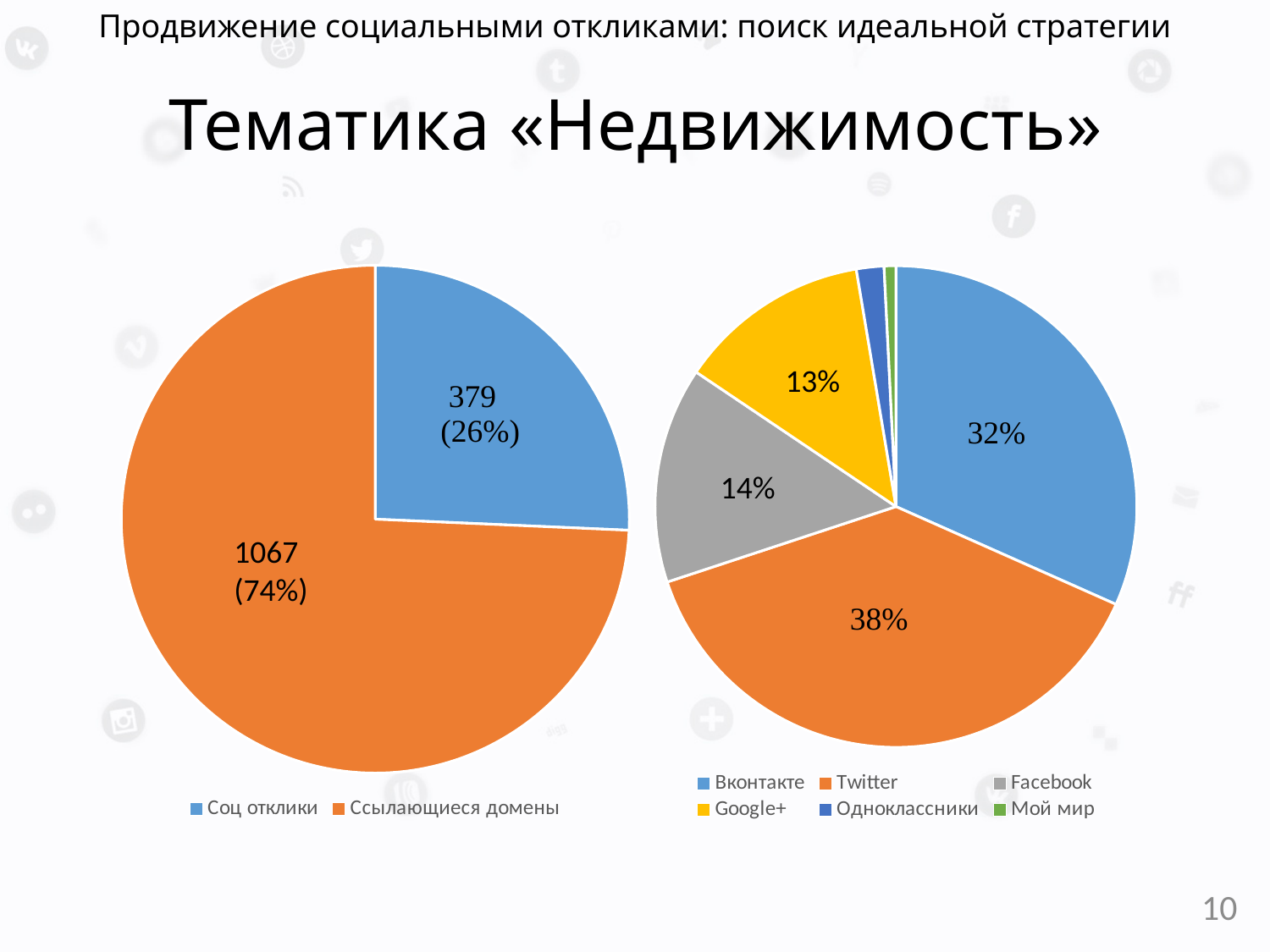
How many entries does the legend of the right pie chart list? 6 In the right pie chart, what percentage is shown for Вконтакте? 32% In the left pie chart, what value is shown for Соц отклики? 379 In the right pie chart, which category has the largest slice? Twitter In the right pie chart, what percentage is shown for Twitter? 38% What type of chart is the chart on the left of the slide? Pie chart In the left pie chart, which category is larger, Соц отклики or Ссылающиеся домены? Ссылающиеся домены In the right pie chart, what percentage is shown for Facebook? 14% In the left pie chart, what is the difference between the values for Ссылающиеся домены and Соц отклики? 688 In the right pie chart, what is the difference between the Facebook and Google+ percentages? 1% In the left pie chart, what share of the pie does Ссылающиеся домены take? 74% In the left pie chart, what value is shown for Ссылающиеся домены? 1067